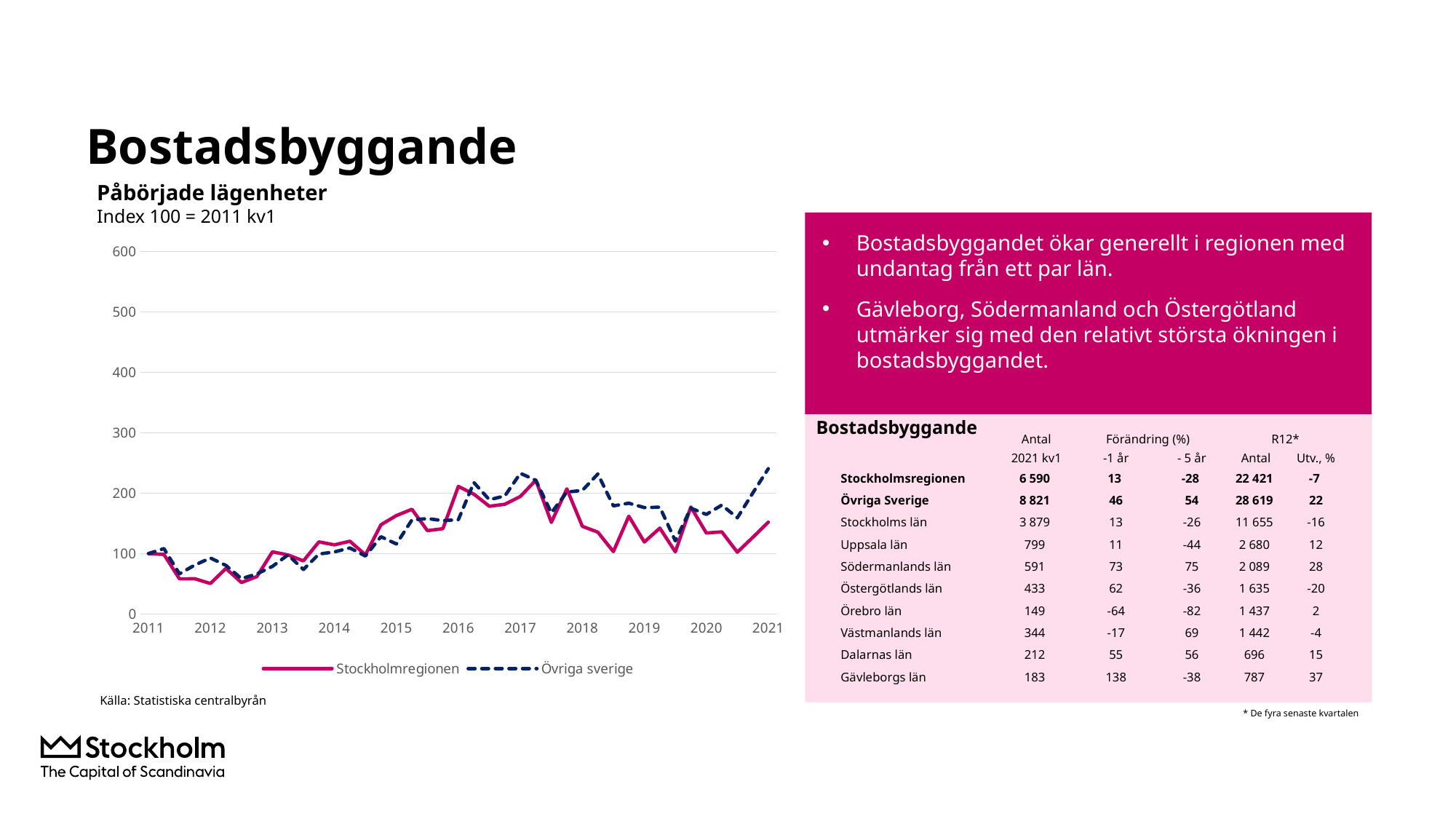
What is the index value of both series at the start of the 'Påbörjade lägenheter' chart in 2011 kv1? 100 In the 'Påbörjade lägenheter' chart, is the value for Övriga sverige at 2017 greater or less than 200? greater How many series does the legend of the 'Påbörjade lägenheter' chart list? 2 In the 'Påbörjade lägenheter' chart, is the value for Stockholmregionen at 2021 greater or less than 200? less What is the highest value shown on the y axis of the 'Påbörjade lägenheter' chart? 600 What are the two series named in the legend of the 'Påbörjade lägenheter' chart? Stockholmregionen and Övriga sverige In the 'Påbörjade lägenheter' chart, does the Övriga sverige line rise or fall between 2020 and 2021? rise What kind of chart is shown under the heading 'Påbörjade lägenheter'? line chart In the 'Påbörjade lägenheter' chart, is the value for Stockholmregionen at 2012 greater or less than 100? less In the 'Påbörjade lägenheter' chart, which series reaches the highest point anywhere on the chart? Övriga sverige In the 'Påbörjade lägenheter' chart, which series has the higher value at 2021, Stockholmregionen or Övriga sverige? Övriga sverige